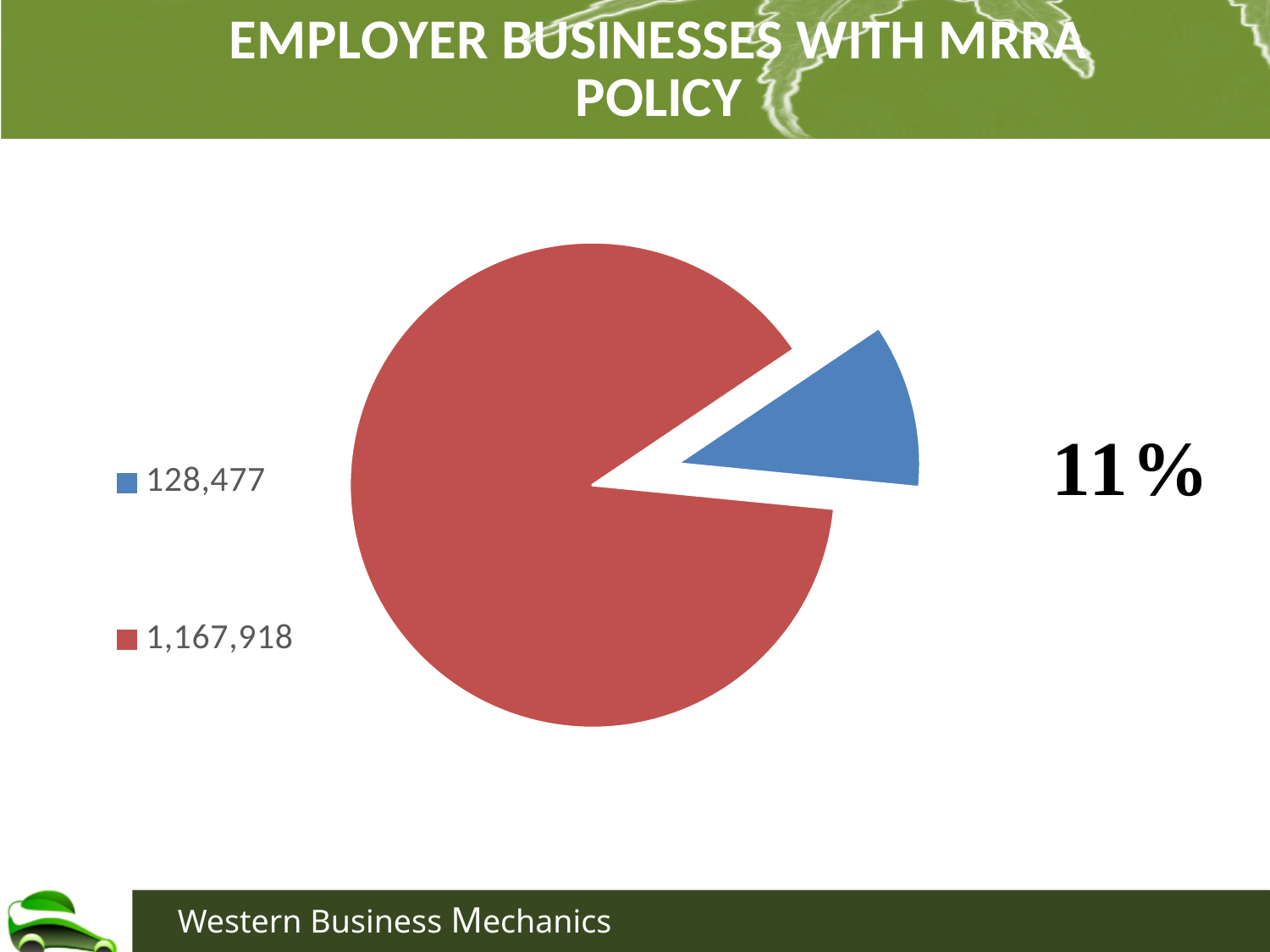
What is the total of the two slice values shown in the legend? 1,296,395 What kind of chart is shown on the slide? pie chart What is the difference between the two slice values, 1,167,918 and 128,477? 1,039,441 What value does the blue slice represent? 128,477 How many slices does the pie chart have? 2 Which is larger, the blue slice or the red slice? red slice Which slice is the largest? 1,167,918 (red) What percentage share is labelled for the blue slice? 11% What value does the red slice represent? 1,167,918 Which slice is the smallest? 128,477 (blue) How many entries does the legend list? 2 What is the title of the slide containing the pie chart? EMPLOYER BUSINESSES WITH MRRA POLICY